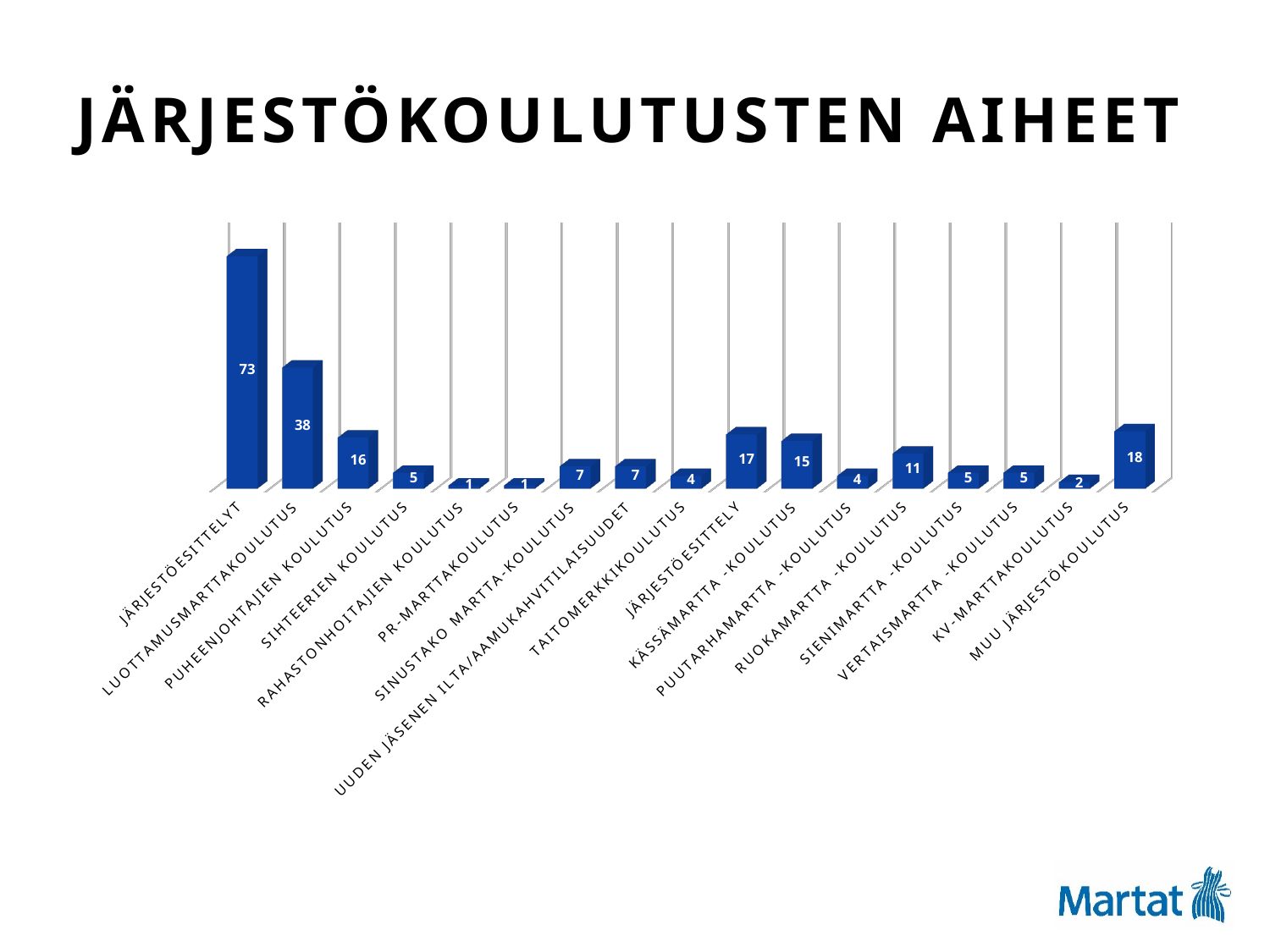
Which is larger, the value for RUOKAMARTTA -KOULUTUS or the value for SIENIMARTTA -KOULUTUS? RUOKAMARTTA -KOULUTUS Which category has the highest value? JÄRJESTÖESITTELYT What is the difference between the values for JÄRJESTÖESITTELYT and LUOTTAMUSMARTTAKOULUTUS? 35 What is the value for RUOKAMARTTA -KOULUTUS? 11 How many categories are shown in the chart? 17 What is the value for KV-MARTTAKOULUTUS? 2 What is the value for LUOTTAMUSMARTTAKOULUTUS? 38 What is the difference between the values for JÄRJESTÖESITTELY and KÄSSÄMARTTA -KOULUTUS? 2 What is the value for MUU JÄRJESTÖKOULUTUS? 18 What kind of chart is shown on the slide? Bar chart What is the title of the slide? JÄRJESTÖKOULUTUSTEN AIHEET Which is larger, the value for PUHEENJOHTAJIEN KOULUTUS or the value for MUU JÄRJESTÖKOULUTUS? MUU JÄRJESTÖKOULUTUS